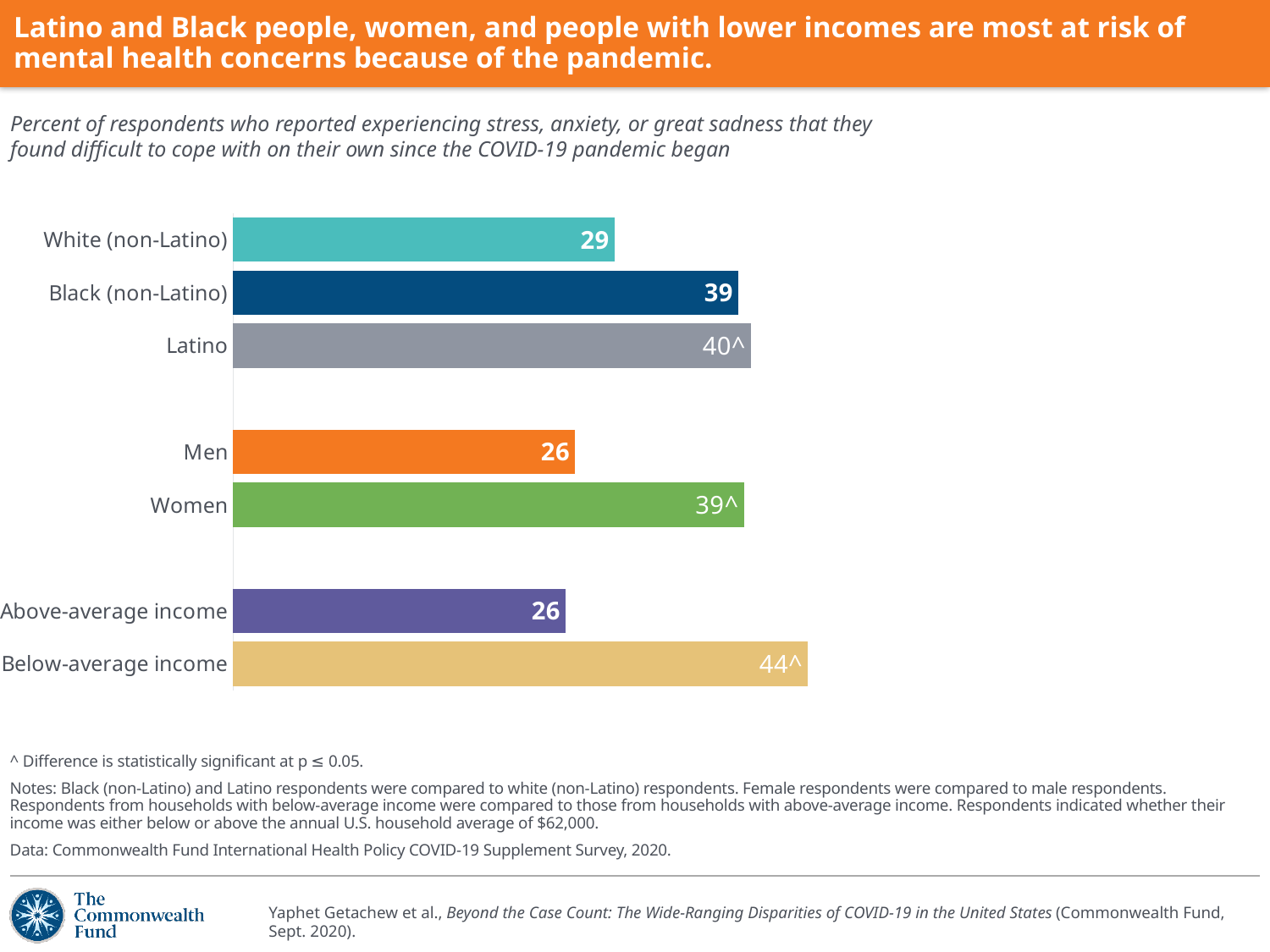
What is the value for White (non-Latino)? 29 What kind of chart is shown on the slide? Bar chart What is the difference between the values for Below-average income and Above-average income? 18 Which of the two income groups has the lower value? Above-average income What is the value for Below-average income? 44 How many categories are shown in the chart? 7 Which category has the highest value? Below-average income What is the difference between the values for Women and Men? 13 What is the value for Men? 26 What is the value for Black (non-Latino)? 39 Which is larger, the value for Black (non-Latino) or White (non-Latino)? Black (non-Latino) What is the difference between the values for Latino and White (non-Latino)? 11